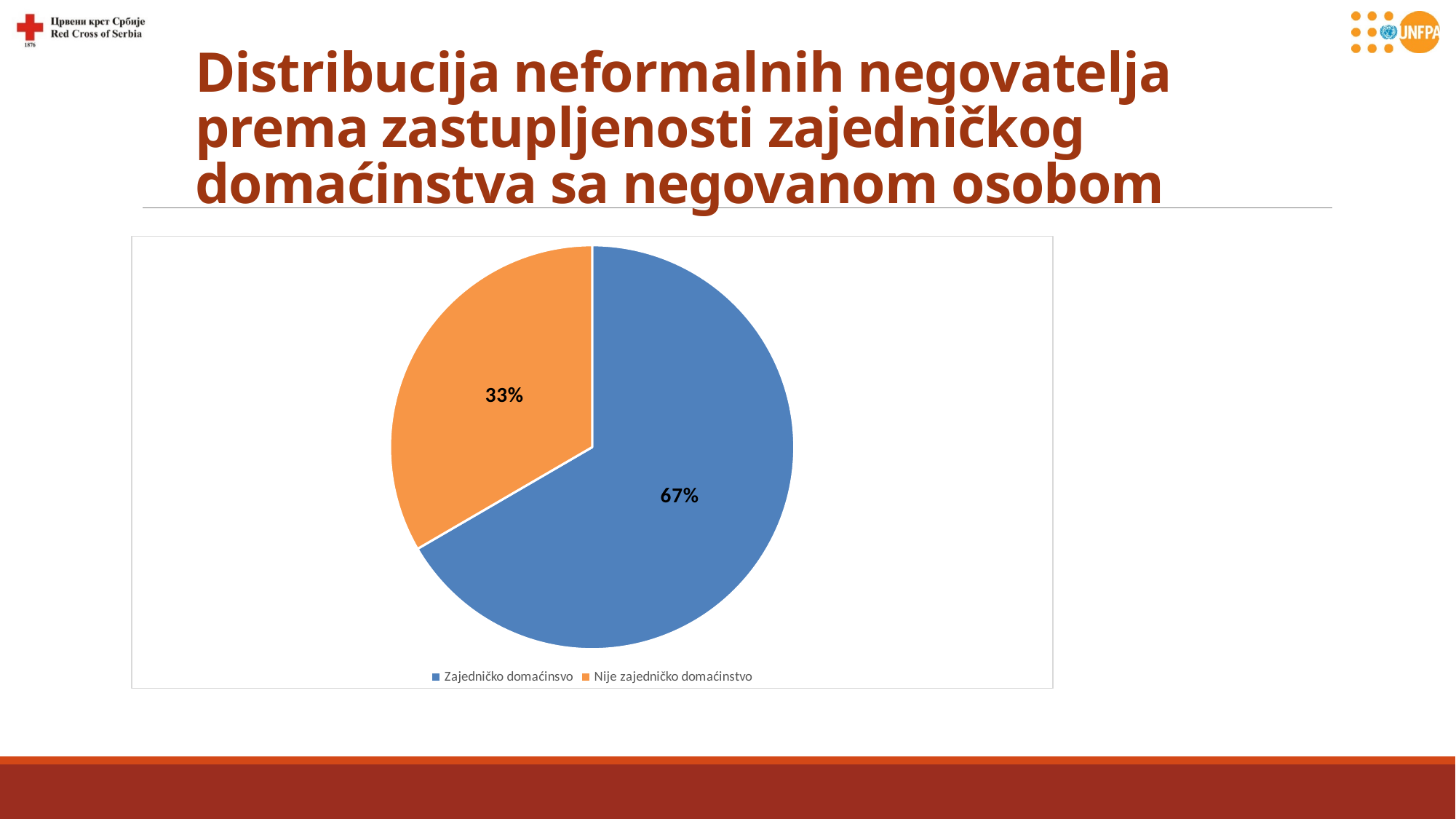
What share of the pie does "Zajedničko domaćinsvo" take? 67% Which is larger: the "Zajedničko domaćinsvo" slice or the "Nije zajedničko domaćinstvo" slice? Zajedničko domaćinsvo What is the difference in percentage points between the "Zajedničko domaćinsvo" slice and the "Nije zajedničko domaćinstvo" slice? 34 What colour is the "Nije zajedničko domaćinstvo" slice? orange Which slice of the pie is the largest? Zajedničko domaćinsvo What kind of chart is shown on the slide? pie chart Which slice of the pie is the smallest? Nije zajedničko domaćinstvo How many slices does the pie chart have? 2 What share of the pie does "Nije zajedničko domaćinstvo" take? 33% How many entries does the legend list? 2 What colour is the "Zajedničko domaćinsvo" slice? blue